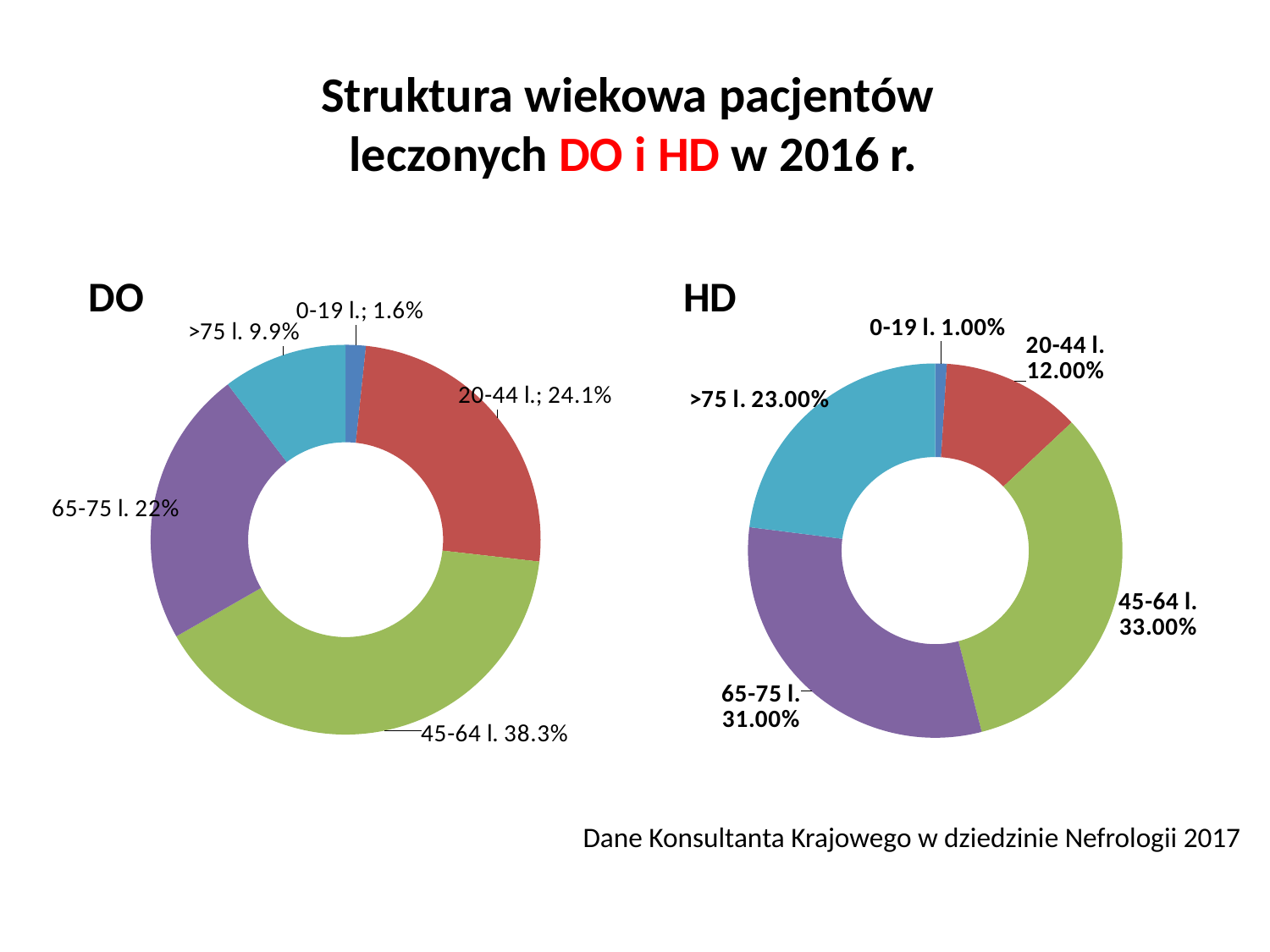
In the HD chart, what is the value for the 20-44 l. group? 12.00% How many age groups are shown in the DO chart? 5 In the HD chart, what share of patients are aged 65-75? 31.00% In the DO chart, what is the value for the >75 l. group? 9.9% In the DO chart, what share of patients are aged 45-64? 38.3% In the HD chart, what is the difference between the 45-64 l. share and the 65-75 l. share? 2.00% What is the title of the slide? Struktura wiekowa pacjentów leczonych DO i HD w 2016 r. What type of chart is the HD chart? Doughnut (pie) chart In the DO chart, which age group has the largest share? 45-64 l. In the HD chart, which age group has the smallest share? 0-19 l. In the DO chart, what is the difference between the 45-64 l. share and the 20-44 l. share? 14.2% Which is larger: the >75 l. share in the DO chart or the >75 l. share in the HD chart? HD chart